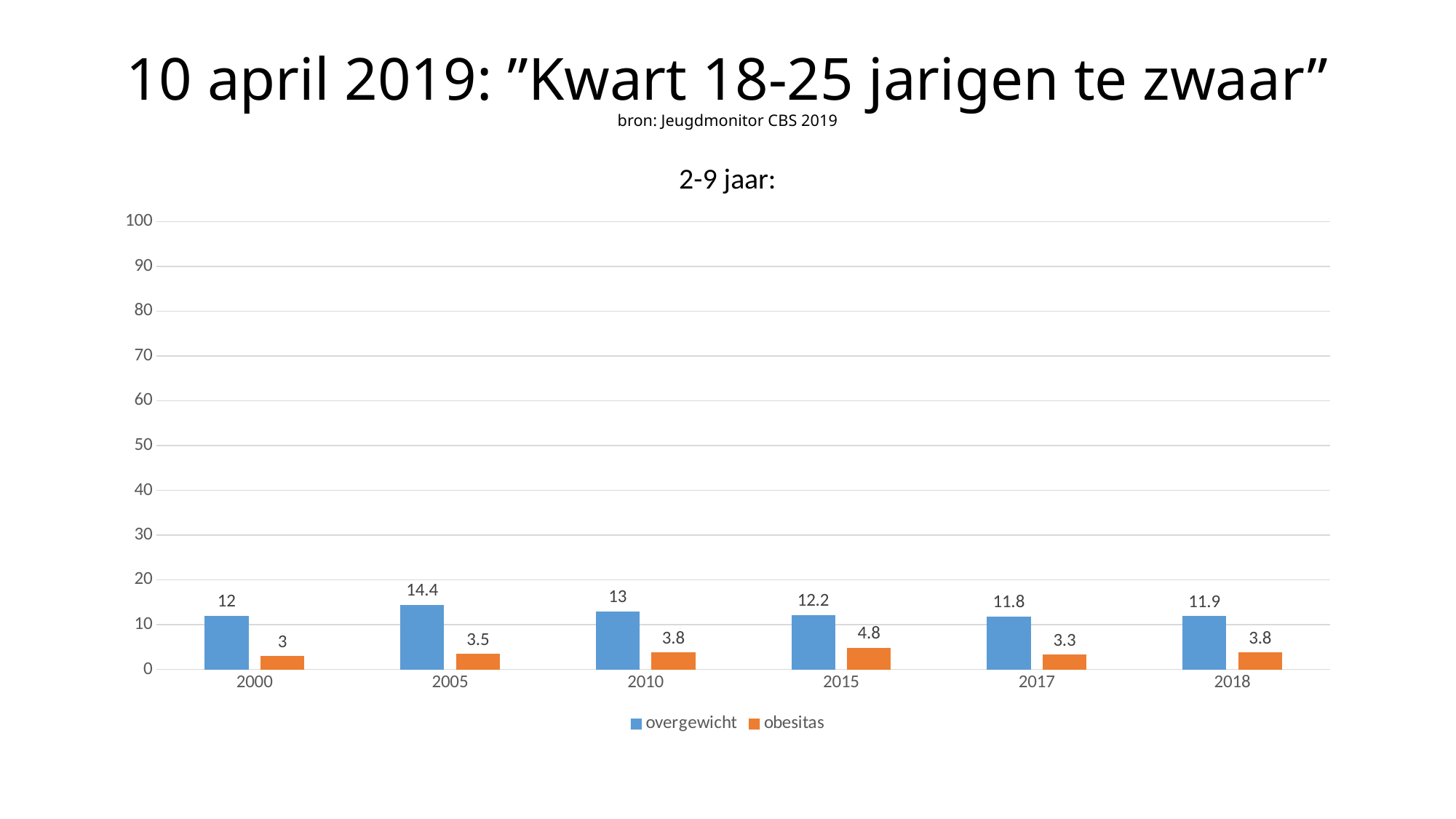
What is the title of the chart? 2-9 jaar: How many series does the legend list? 2 In which year is the overgewicht value highest? 2005 What is the value for overgewicht in 2018? 11.9 Is the value for overgewicht in 2000 greater or less than 20? less What is the value for overgewicht in 2005? 14.4 What is the value for obesitas in 2015? 4.8 What is the difference between the overgewicht values for 2005 and 2017? 2.6 How many years are shown on the x axis? 6 Which is larger: the obesitas value for 2010 or for 2017? 2010 In which year is the obesitas value lowest? 2000 What kind of chart is shown? bar chart